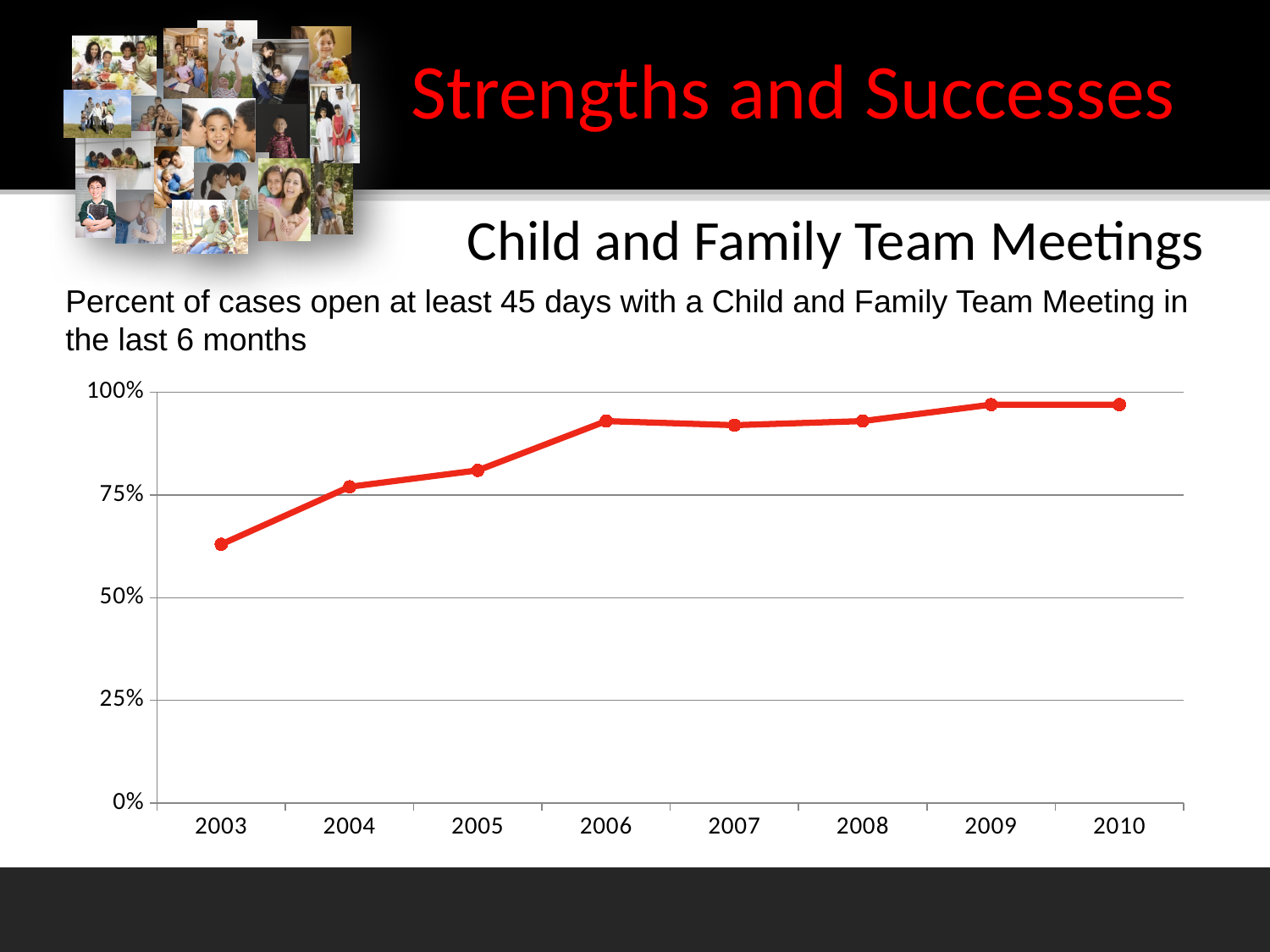
Is the value for 2003 greater or less than 75%? less Is the value for 2003 greater or less than 50%? greater Which year has the lowest percent of cases with a Child and Family Team Meeting in the last 6 months? 2003 Is the value for 2006 greater or less than 75%? greater Do the values generally rise or fall from 2003 to 2010? rise What is the title of the chart? Child and Family Team Meetings How many years are plotted on the x axis of the chart? 8 Which is larger, the value for 2003 or the value for 2004? 2004 Which is larger, the value for 2005 or the value for 2006? 2006 What kind of chart is shown on the slide? line chart